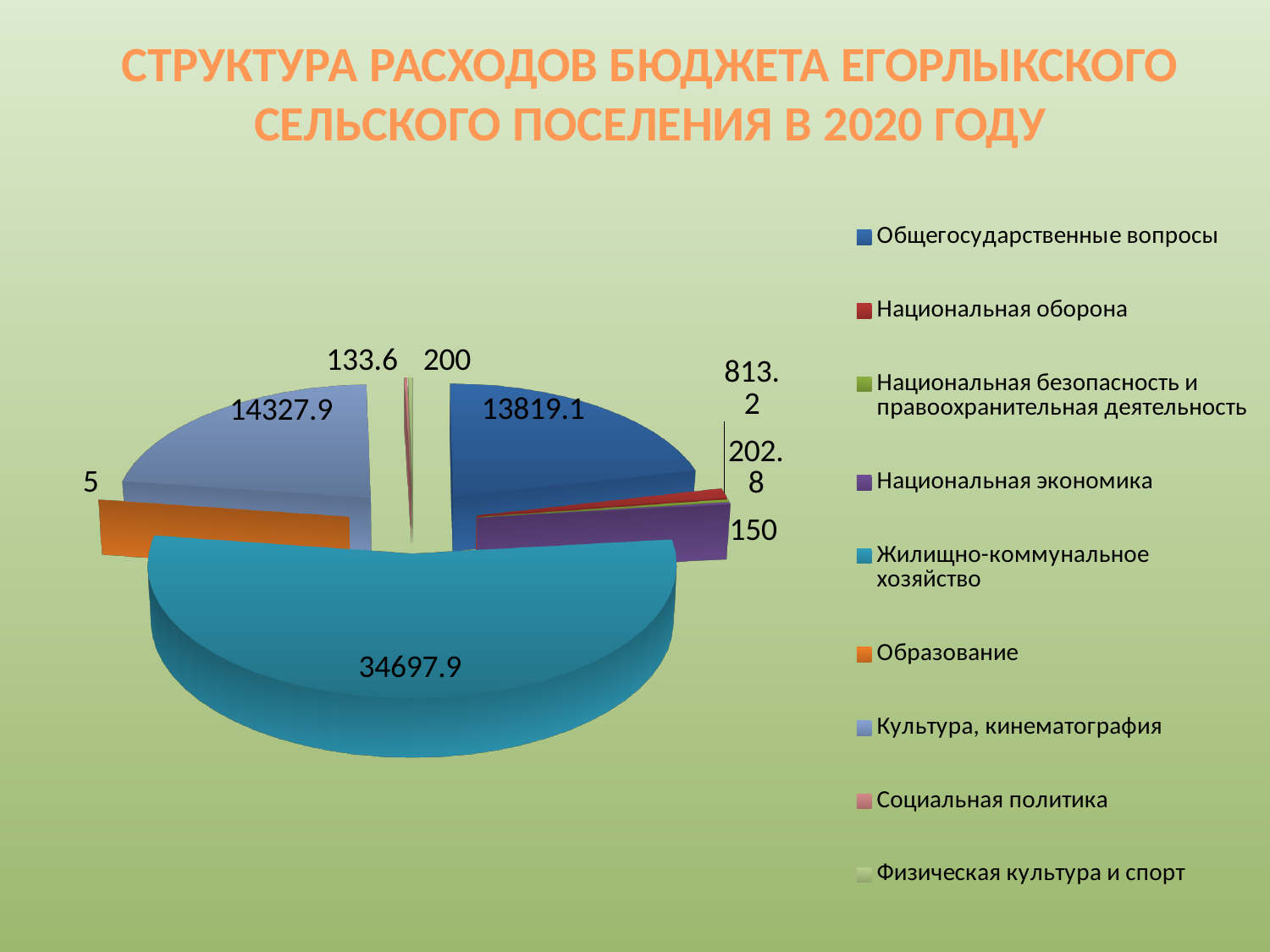
What is the difference between Национальная оборона and Национальная безопасность и правоохранительная деятельность? 610.4 What is the value for Жилищно-коммунальное хозяйство? 34697.9 What is the value for Общегосударственные вопросы? 13819.1 Which category has the smallest value? Образование What is the value for Национальная оборона? 813.2 Which is larger: Культура, кинематография or Общегосударственные вопросы? Культура, кинематография What is the value for Культура, кинематография? 14327.9 How many categories does the legend list? 9 What type of chart is shown on the slide? pie chart What is the difference between Культура, кинематография and Общегосударственные вопросы? 508.8 What is the value for Образование? 5 Which category has the largest slice? Жилищно-коммунальное хозяйство